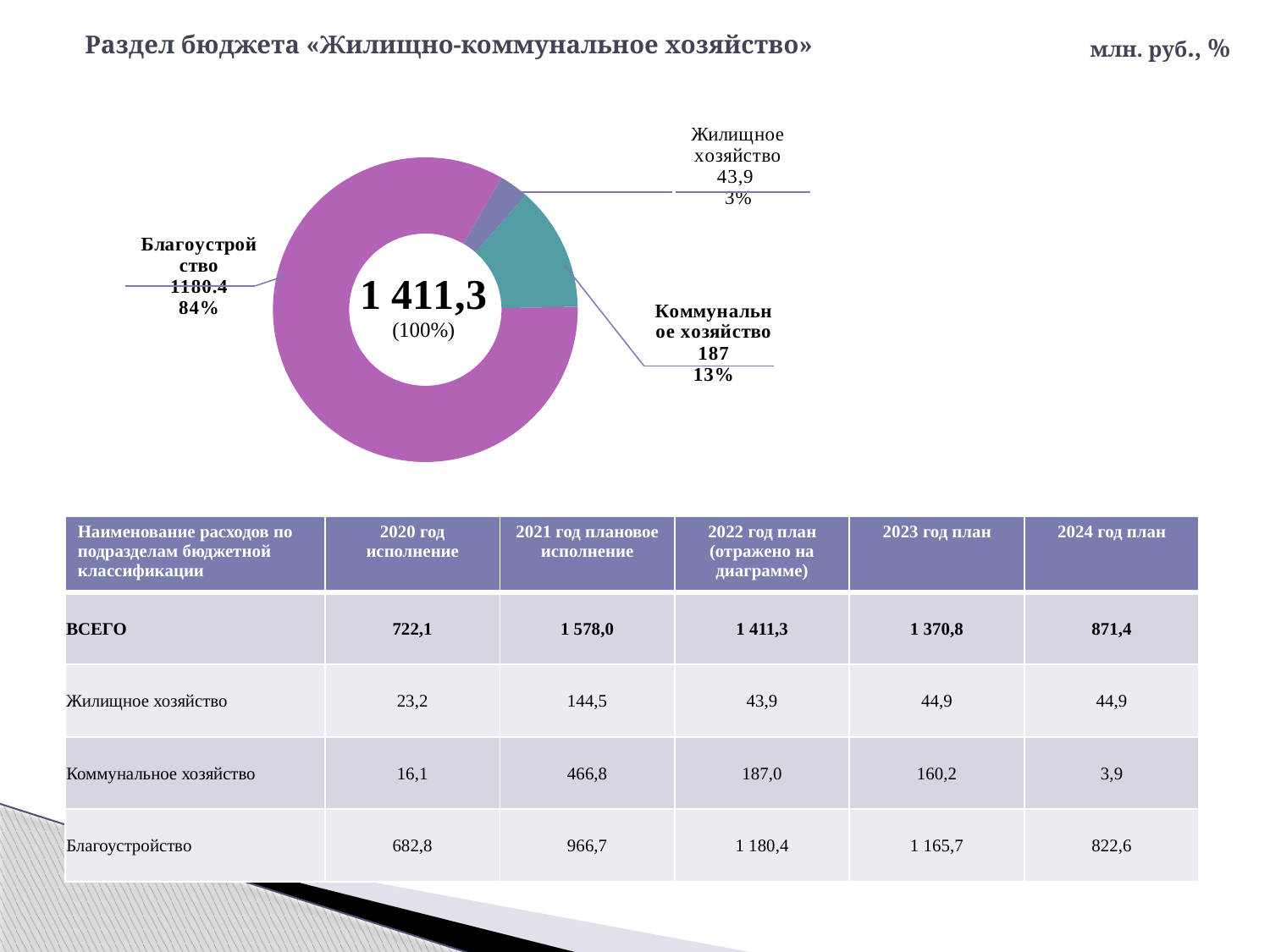
What kind of chart is shown on the slide? Donut (pie) chart Which category has the largest slice in the donut chart? Благоустройство What is the value shown for Жилищное хозяйство on the donut chart? 43,9 What is the value shown for Коммунальное хозяйство on the donut chart? 187 What share of the donut chart does Коммунальное хозяйство account for? 13% Which category has the smallest slice in the donut chart? Жилищное хозяйство How many slices does the donut chart have? 3 What share of the donut chart does Жилищное хозяйство account for? 3% Which is larger on the donut chart: Коммунальное хозяйство or Жилищное хозяйство? Коммунальное хозяйство What total value is shown in the centre of the donut chart? 1 411,3 What share of the donut chart does Благоустройство account for? 84% What is the title of the slide containing the donut chart? Раздел бюджета «Жилищно-коммунальное хозяйство»